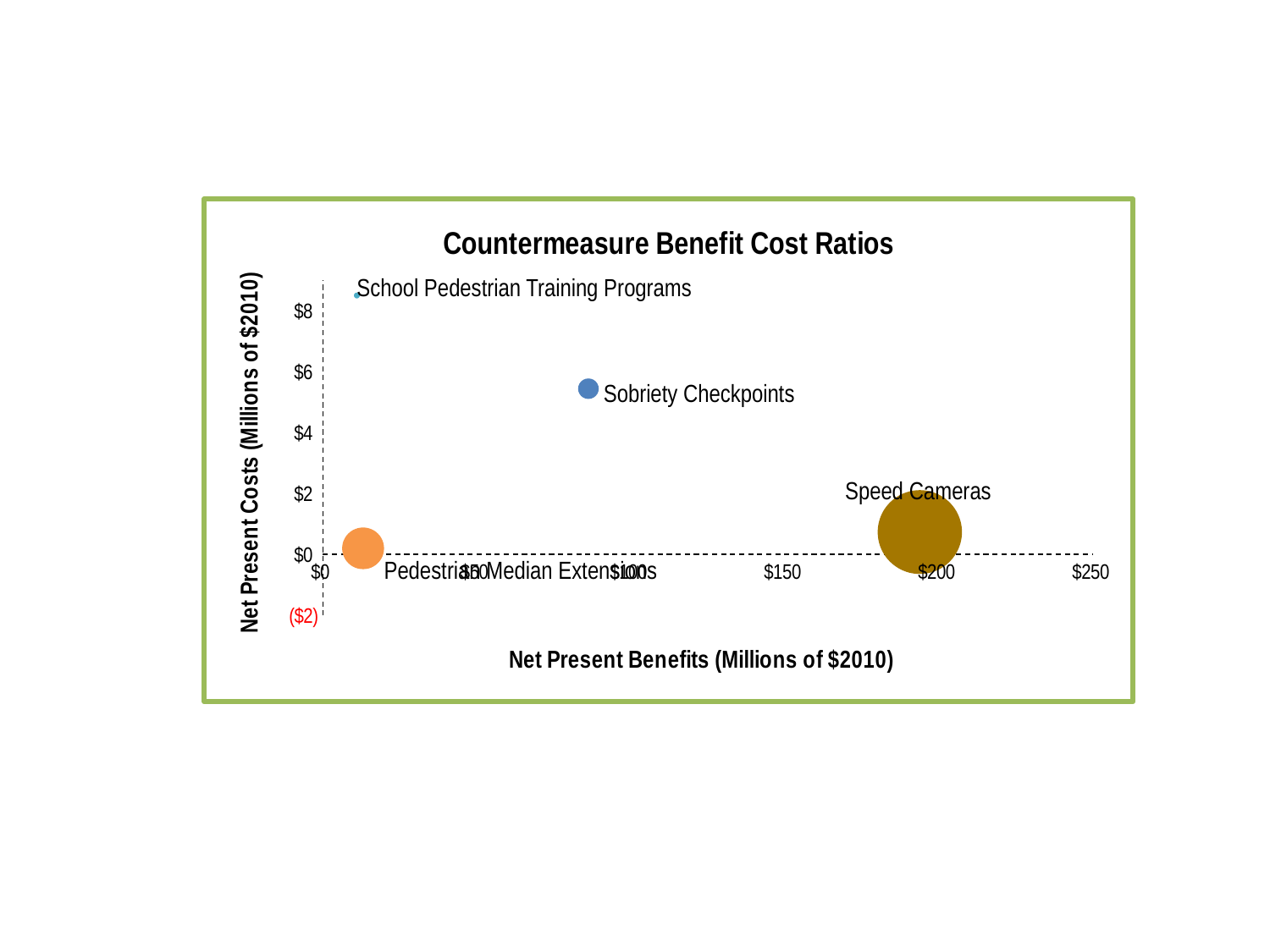
Which has higher net present costs, Sobriety Checkpoints or Speed Cameras? Sobriety Checkpoints Which countermeasure has the highest net present benefits? Speed Cameras Which countermeasure has the highest net present costs? School Pedestrian Training Programs Is the net present benefits value for Speed Cameras greater or less than $150? greater Which has higher net present benefits, Sobriety Checkpoints or Pedestrian Median Extensions? Sobriety Checkpoints What kind of chart is shown on the slide? bubble chart How many countermeasures are plotted on the chart? 4 What is the title of the chart? Countermeasure Benefit Cost Ratios Is the net present costs value for Sobriety Checkpoints greater or less than $4? greater What is the label of the x axis? Net Present Benefits (Millions of $2010) Is the net present benefits value for Sobriety Checkpoints greater or less than $100? less